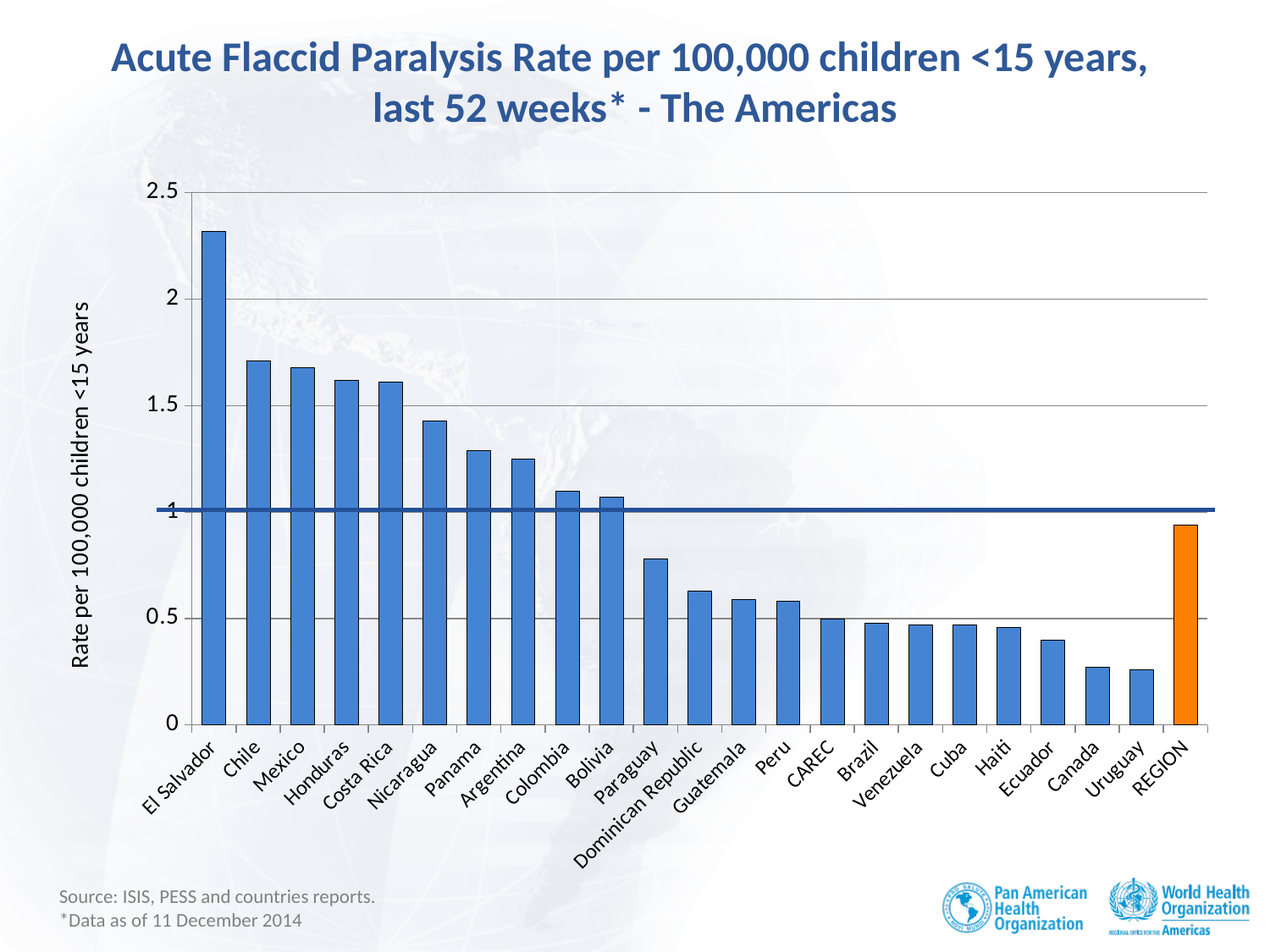
Which has a higher rate, Paraguay or Dominican Republic? Paraguay What colour is the bar for REGION? orange Is the value for Nicaragua greater or less than 1.5? less Is the value for Chile greater or less than 1.5? greater Is the value for El Salvador greater or less than 2? greater Which category has the highest Acute Flaccid Paralysis rate? El Salvador Do the country values rise or fall from left to right along the x axis (from El Salvador to Uruguay)? fall What kind of chart is shown on the slide? bar chart How many categories are plotted along the x axis? 23